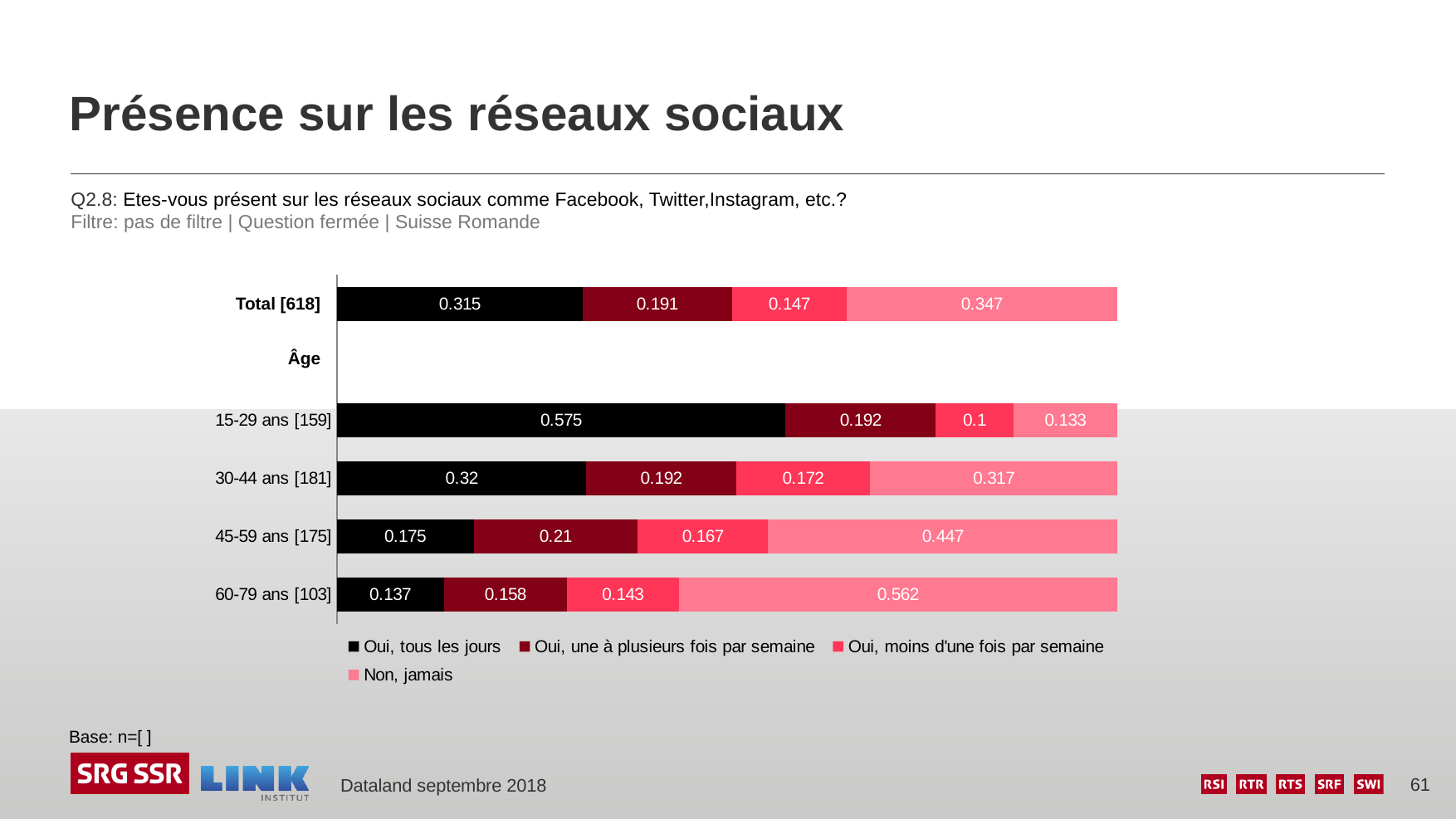
How many series does the legend list? 4 What is the difference between the "Non, jamais" values for 60-79 ans [103] and 15-29 ans [159]? 0.429 What kind of chart is shown on the slide? Stacked bar chart What is the value for "Oui, tous les jours" in the 15-29 ans [159] category? 0.575 Which is larger: the "Oui, tous les jours" value for 30-44 ans [181] or for 45-59 ans [175]? 30-44 ans [181] Which age group has the highest value for "Oui, tous les jours"? 15-29 ans [159] Which age group has the lowest value for "Non, jamais"? 15-29 ans [159] Which legend entry is shown in black? Oui, tous les jours How many bars are plotted in the chart? 5 What is the value for "Non, jamais" in the 60-79 ans [103] category? 0.562 What is the value for "Oui, moins d'une fois par semaine" in the Total [618] category? 0.147 What is the value for "Oui, une à plusieurs fois par semaine" in the 45-59 ans [175] category? 0.21